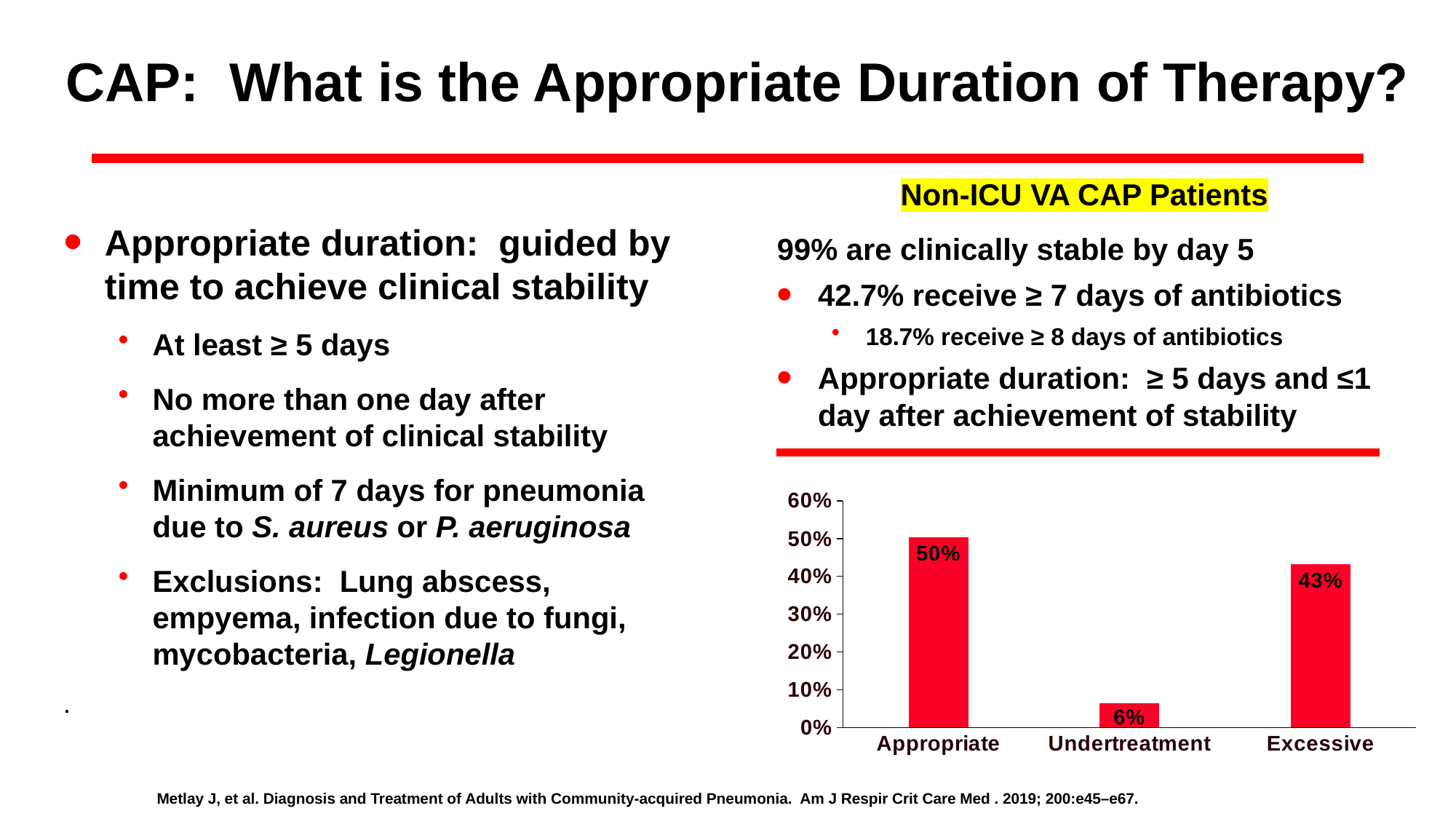
Which category has the highest value in the bar chart? Appropriate What is the value for Appropriate in the bar chart? 50% How many categories are shown in the bar chart? 3 What kind of chart is shown on the slide? Bar chart What is the difference between the values for Excessive and Undertreatment? 37% What is the value for Excessive in the bar chart? 43% What is the difference between the values for Appropriate and Excessive? 7% Which is larger, the value for Appropriate or the value for Excessive? Appropriate Which category has the lowest value in the bar chart? Undertreatment What is the highest value shown on the y axis of the bar chart? 60% Is the value for Excessive greater or less than 40%? greater What is the value for Undertreatment in the bar chart? 6%